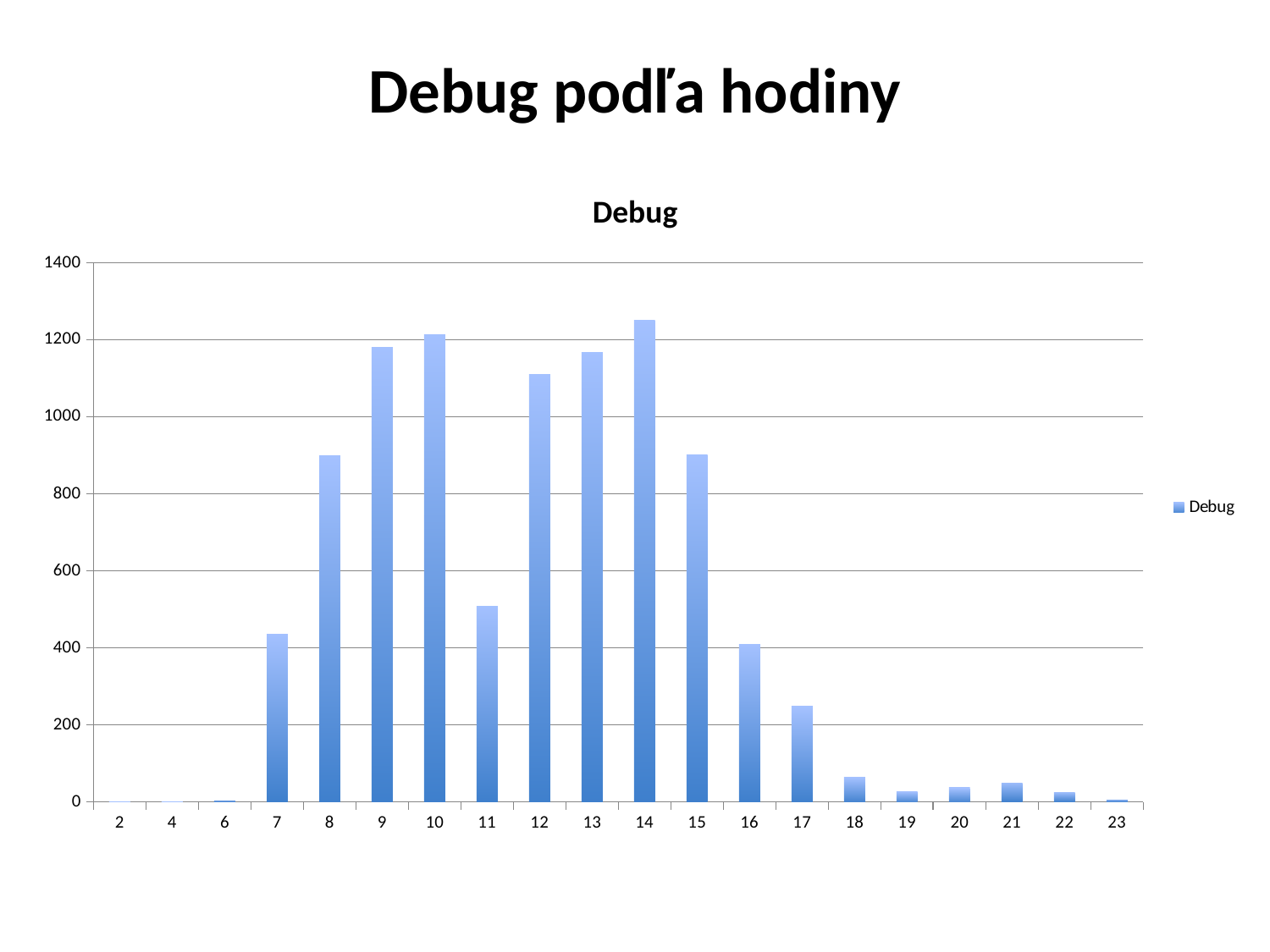
How many series does the legend list? 1 Which is larger, the value for hour 9 or hour 11? 9 Is the value for hour 8 greater or less than 800? greater How many categories are shown on the x axis? 20 What kind of chart is shown on the slide? bar chart Is the value for hour 17 greater or less than 200? greater What is the title of the chart? Debug Which hour has the highest value? 14 Is the value for hour 18 greater or less than 200? less Do the values rise or fall from hour 14 to hour 23? fall Which is larger, the value for hour 13 or hour 17? 13